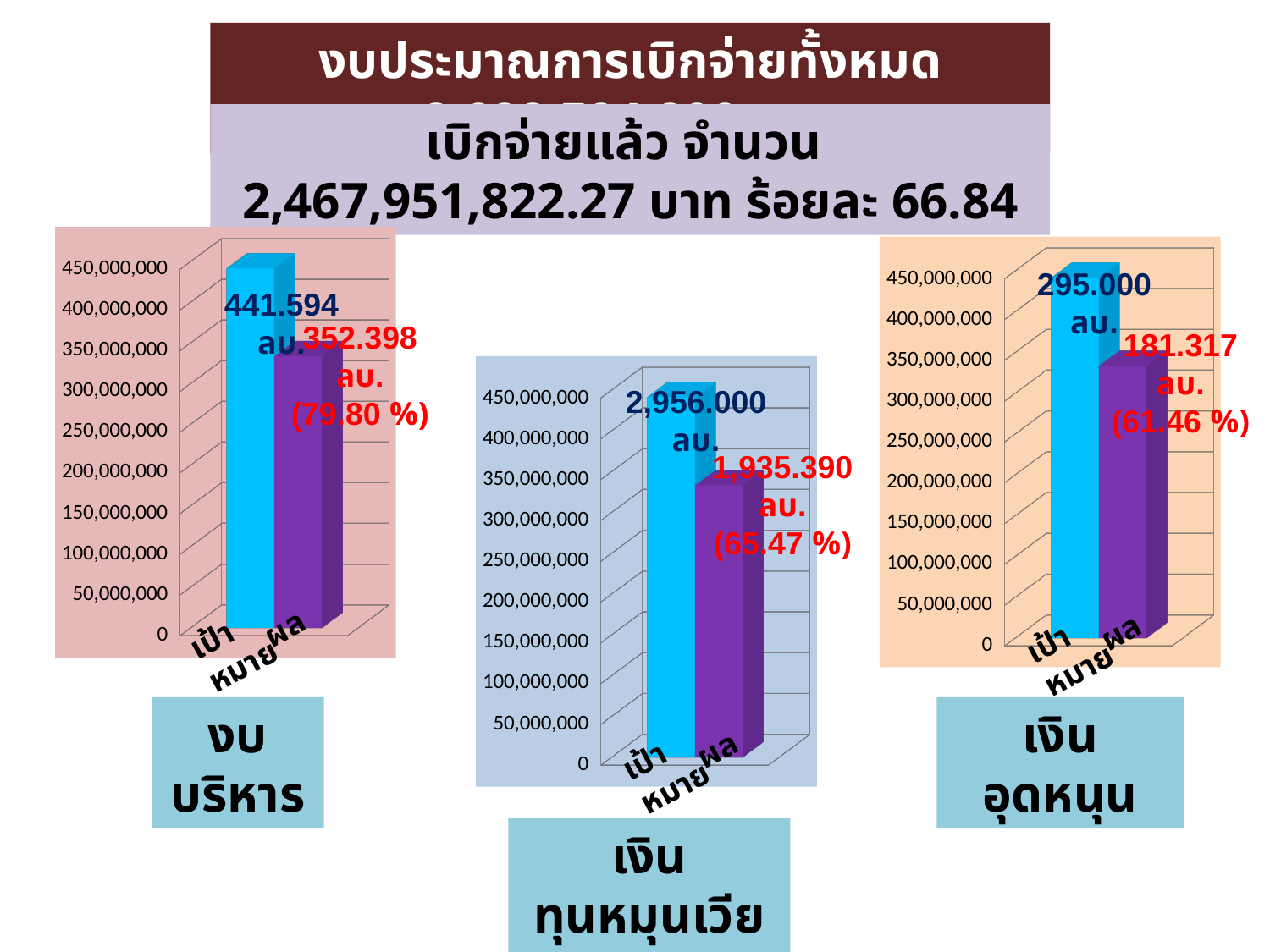
In the เงินอุดหนุน chart, which bar is taller, เป้าหมาย or ผล? เป้าหมาย In the เงินอุดหนุน chart, what is the difference between the เป้าหมาย value and the ผล value? 113.683 ลบ. In the งบบริหาร chart, what is the difference between the เป้าหมาย value and the ผล value? 89.196 ลบ. In the เงินทุนหมุนเวียน chart, what is the value labelled on the เป้าหมาย bar? 2,956.000 ลบ. In the เงินทุนหมุนเวียน chart, what is the value labelled on the ผล bar? 1,935.390 ลบ. How many bars does the เงินทุนหมุนเวียน chart have? 2 In the เงินอุดหนุน chart, what percentage is shown next to the ผล bar? 61.46 % In the งบบริหาร chart, what percentage is shown next to the ผล bar? 79.80 % In the งบบริหาร chart, what is the value labelled on the เป้าหมาย bar? 441.594 ลบ. What kind of chart is the งบบริหาร chart? Bar chart In the เงินอุดหนุน chart, what is the value labelled on the ผล bar? 181.317 ลบ. In the งบบริหาร chart, what is the value labelled on the ผล bar? 352.398 ลบ.